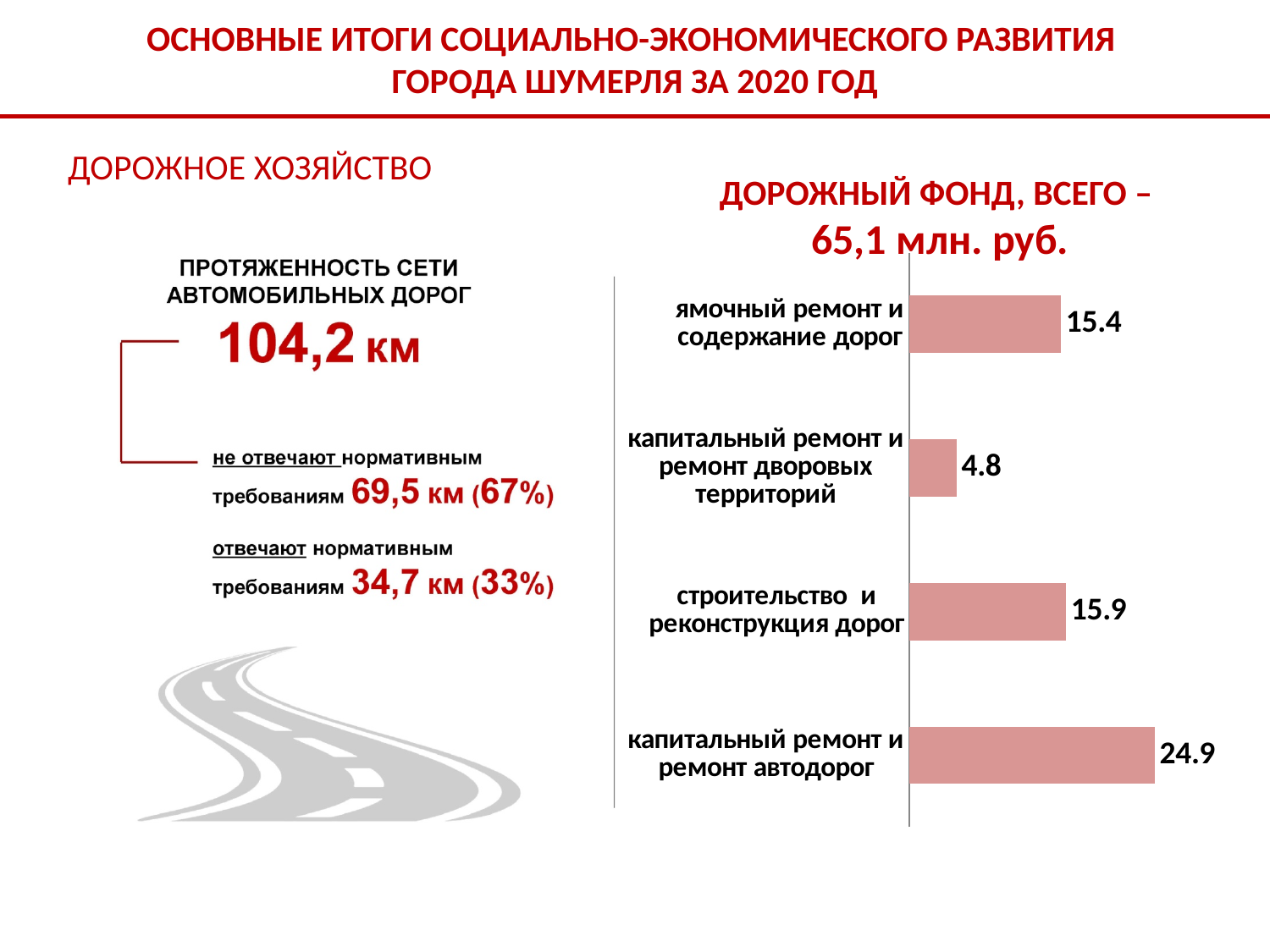
How many categories are shown in the road fund chart? 4 What is the difference between «строительство и реконструкция дорог» and «ямочный ремонт и содержание дорог» in the road fund chart? 0.5 What is the value for «ямочный ремонт и содержание дорог» in the road fund chart? 15.4 What is the value for «капитальный ремонт и ремонт автодорог» in the road fund chart? 24.9 Which category has the highest value in the road fund chart? капитальный ремонт и ремонт автодорог What is the difference between «капитальный ремонт и ремонт автодорог» and «капитальный ремонт и ремонт дворовых территорий» in the road fund chart? 20.1 What is the value for «строительство и реконструкция дорог» in the road fund chart? 15.9 What total amount of the road fund is stated in the chart title? 65,1 млн. руб. What is the value for «капитальный ремонт и ремонт дворовых территорий» in the road fund chart? 4.8 What kind of chart is used to show the road fund breakdown? bar chart Which category has the lowest value in the road fund chart? капитальный ремонт и ремонт дворовых территорий Which is larger in the road fund chart: «ямочный ремонт и содержание дорог» or «капитальный ремонт и ремонт дворовых территорий»? ямочный ремонт и содержание дорог